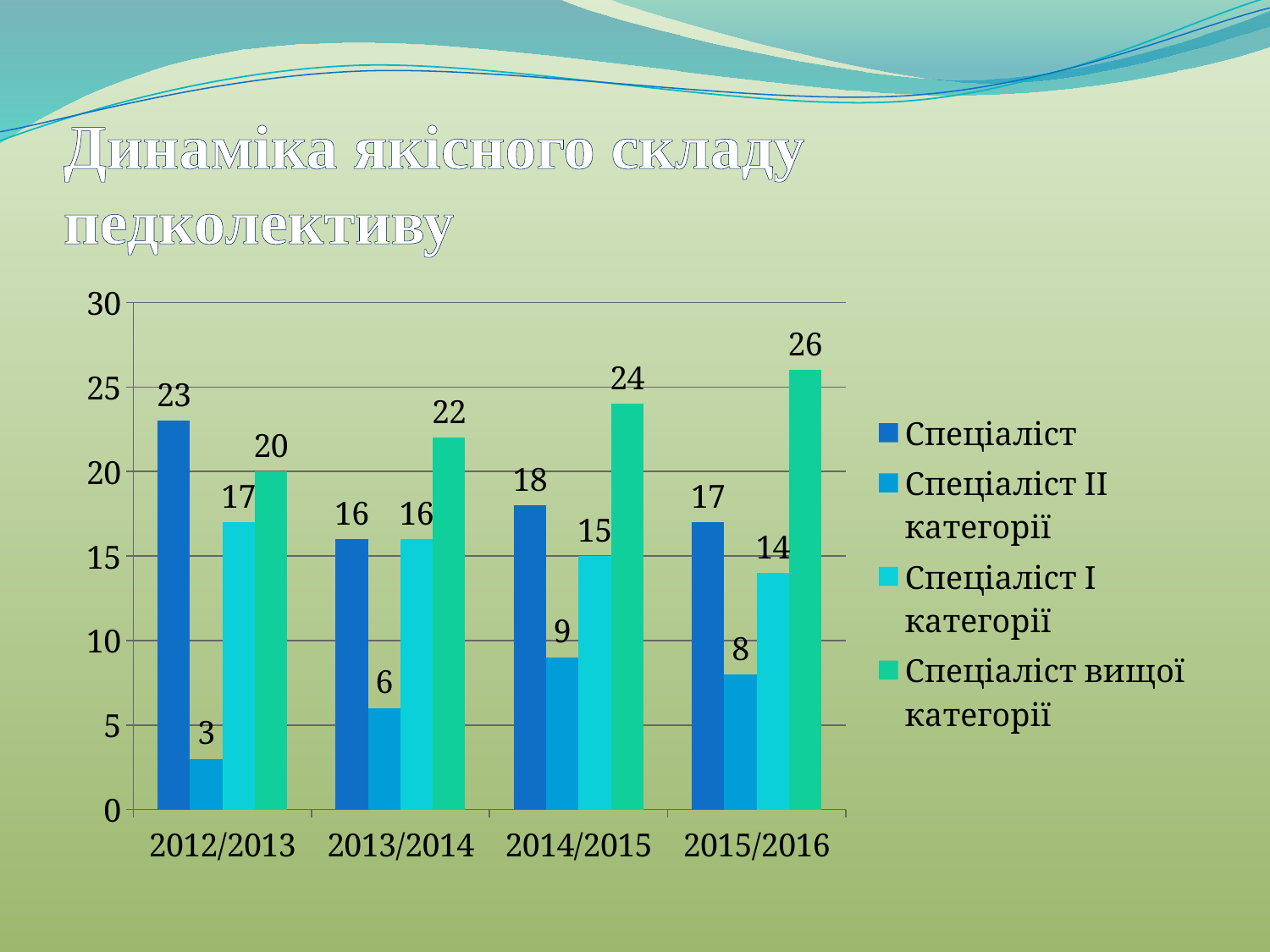
What is the value for Спеціаліст II категорії in 2013/2014? 6 How many series does the legend list? 4 Which is larger in 2013/2014: Спеціаліст or Спеціаліст вищої категорії? Спеціаліст вищої категорії In which year is the value for Спеціаліст II категорії lowest? 2012/2013 What is the value for Спеціаліст I категорії in 2014/2015? 15 In which year is the value for Спеціаліст вищої категорії highest? 2015/2016 What is the value for Спеціаліст in 2012/2013? 23 What is the value for Спеціаліст вищої категорії in 2015/2016? 26 What kind of chart is shown on the slide? Bar chart Does the value for Спеціаліст вищої категорії rise or fall from 2012/2013 to 2015/2016? Rise How many years are shown on the x axis? 4 What is the difference between the Спеціаліст вищої категорії values in 2015/2016 and 2012/2013? 6